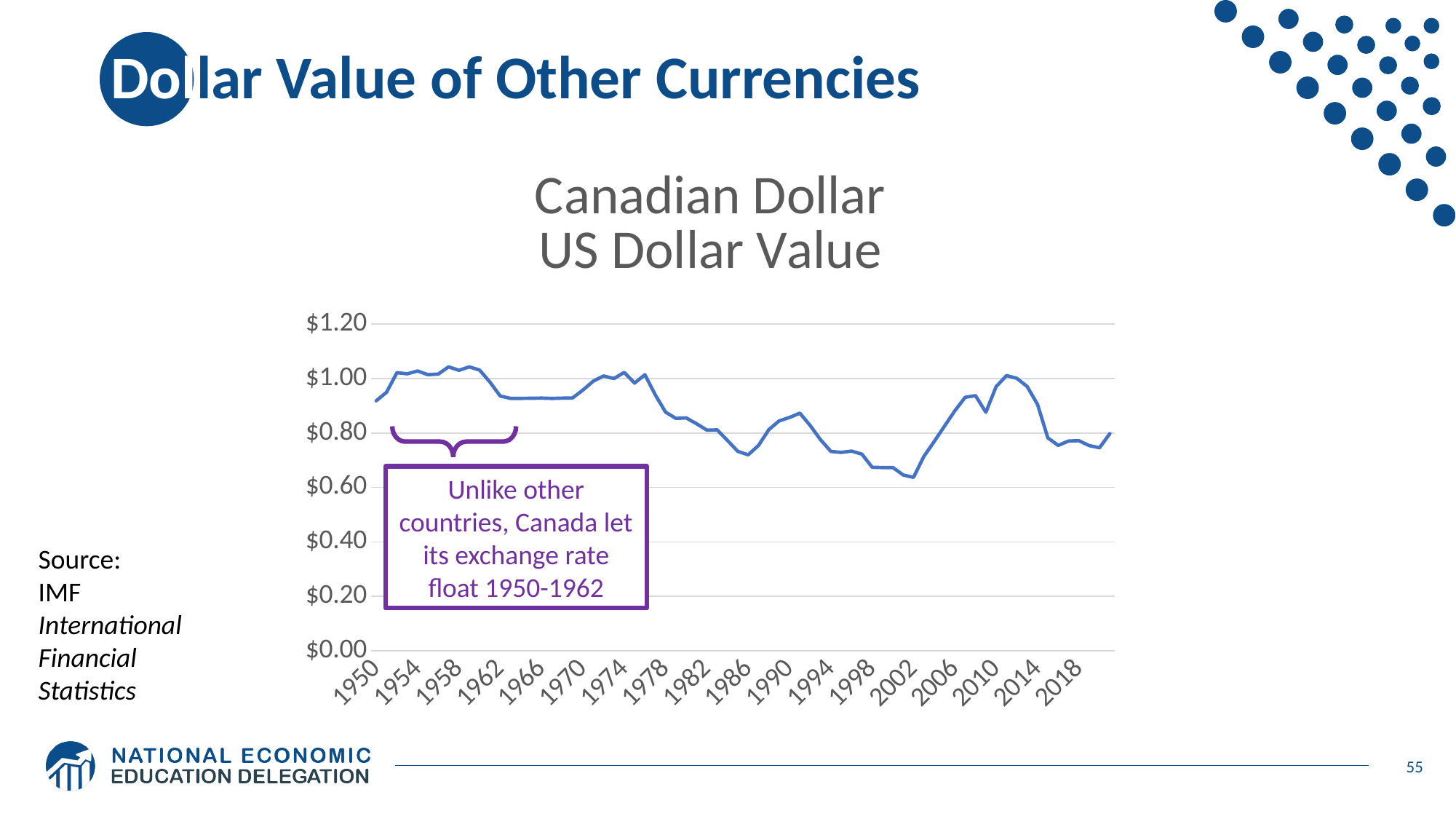
Is the value for 2002 greater or less than $0.80? less According to the annotation on the chart, during which years did Canada let its exchange rate float? 1950-1962 What kind of chart is shown on the slide? line chart Of the years labelled on the x axis, in which year is the value lowest? 2002 Is the value for 2018 greater or less than $1.00? less What is the title of the chart? Canadian Dollar US Dollar Value Is the value for 2010 greater or less than $0.80? greater Does the value rise or fall between 1978 and 1986? fall Which is larger, the value for 1974 or the value for 2002? 1974 Does the value rise or fall between 2002 and 2010? rise